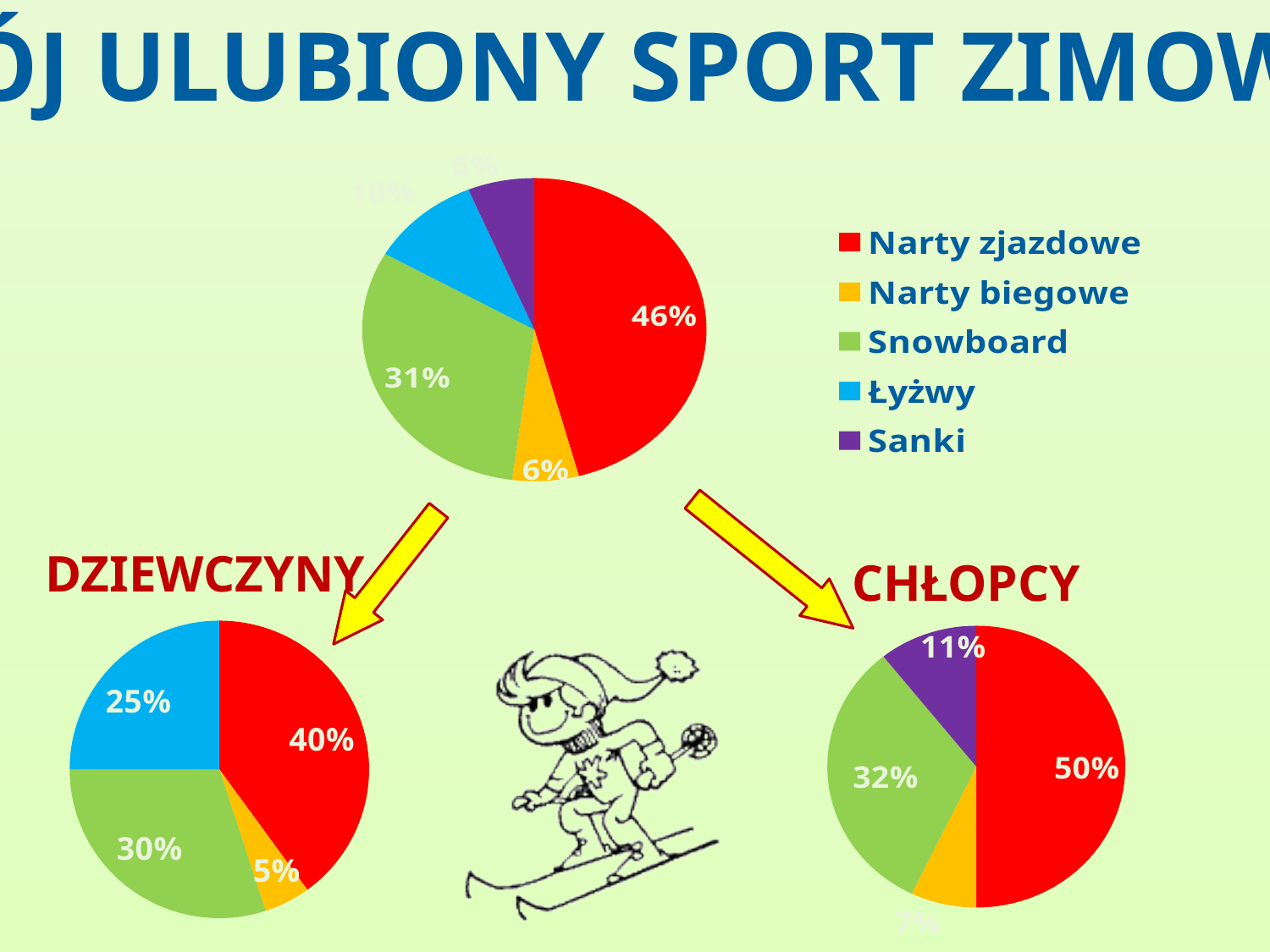
In the DZIEWCZYNY pie chart, what share is Narty biegowe? 5% In the DZIEWCZYNY pie chart, which category has the smallest slice? Narty biegowe In the top pie chart, which category has the largest slice? Narty zjazdowe In the CHŁOPCY pie chart, what share is Narty zjazdowe? 50% What kind of chart is the top chart on the slide? pie chart Which chart shows a larger share for Snowboard, DZIEWCZYNY or CHŁOPCY? CHŁOPCY In the CHŁOPCY pie chart, what share is Sanki? 11% How many entries does the legend list? 5 In the DZIEWCZYNY pie chart, what share is Łyżwy? 25% In the top pie chart, what share is Narty zjazdowe? 46% By how many percentage points is Narty zjazdowe larger in the CHŁOPCY pie chart than in the DZIEWCZYNY pie chart? 10 In the top pie chart, what share is Snowboard? 31%